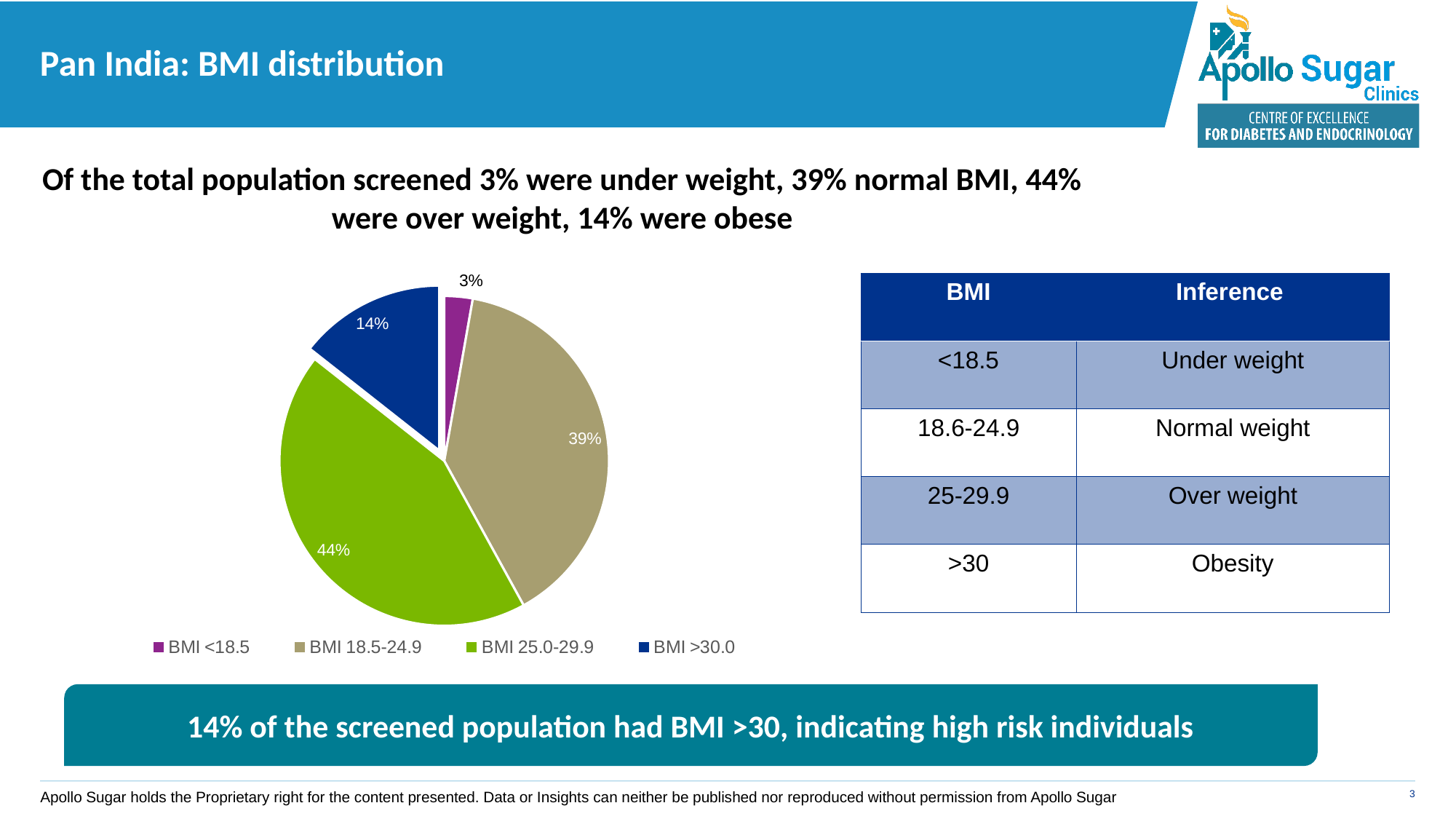
What colour is the BMI >30.0 slice in the pie chart? Dark blue How many slices does the pie chart have? 4 What kind of chart is shown on the slide? Pie chart Which BMI category has the largest slice of the pie? BMI 25.0-29.9 What share of the pie does the BMI >30.0 slice represent? 14% What share of the pie does the BMI 25.0-29.9 slice represent? 44% What share of the pie does the BMI <18.5 slice represent? 3% What is the difference in percentage points between the BMI 25.0-29.9 slice and the BMI 18.5-24.9 slice? 5 percentage points Which BMI category has the smallest slice of the pie? BMI <18.5 How many entries does the legend list? 4 Which is larger, the BMI >30.0 slice or the BMI <18.5 slice? BMI >30.0